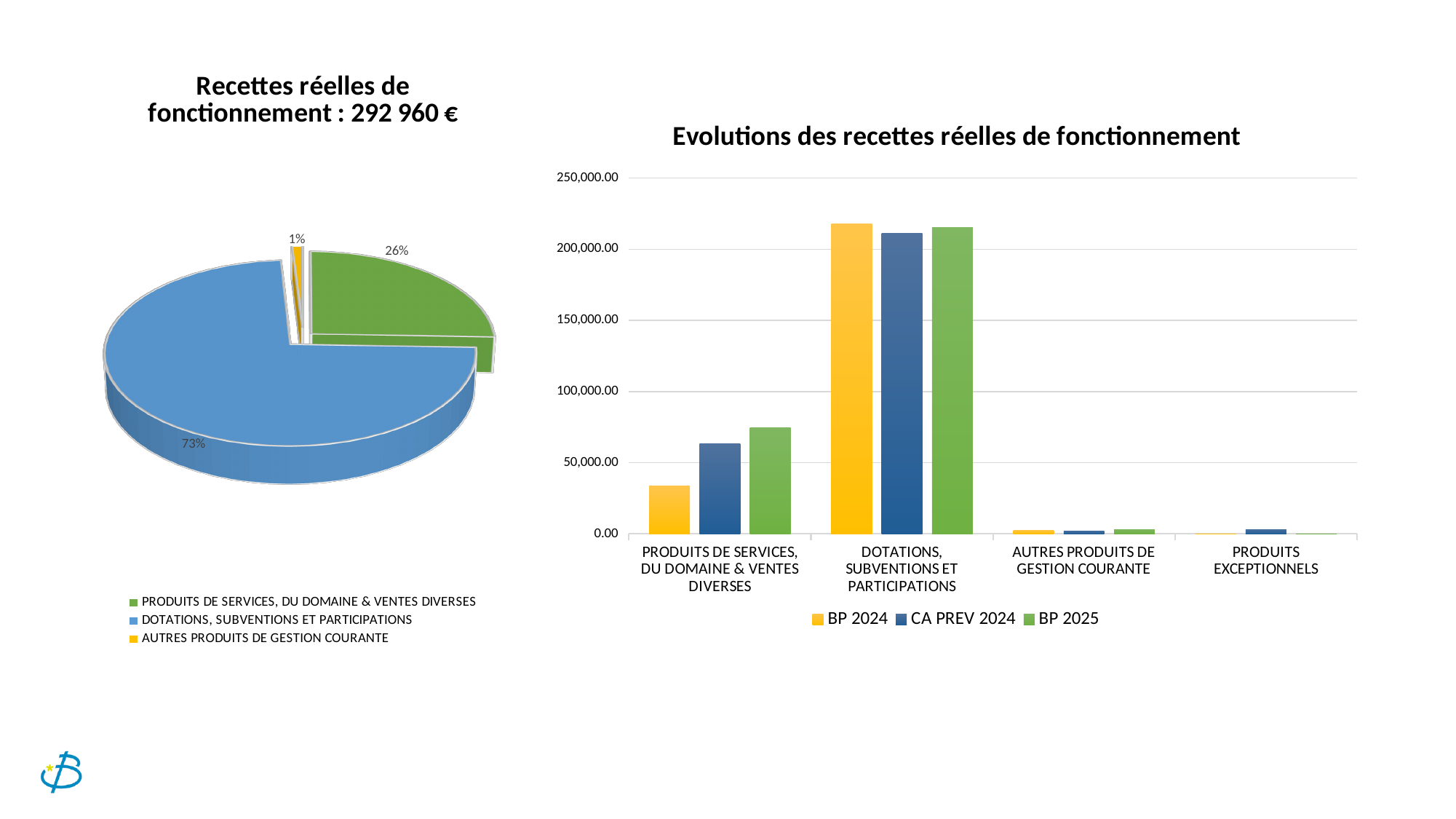
In the bar chart 'Evolutions des recettes réelles de fonctionnement', which category has the highest bars? DOTATIONS, SUBVENTIONS ET PARTICIPATIONS In the pie chart on the left, what share does PRODUITS DE SERVICES, DU DOMAINE & VENTES DIVERSES represent? 26% What total amount is given in the title of the pie chart on the left? 292 960 € In the bar chart 'Evolutions des recettes réelles de fonctionnement', how many series does the legend list? 3 In the bar chart 'Evolutions des recettes réelles de fonctionnement', which is larger for PRODUITS DE SERVICES, DU DOMAINE & VENTES DIVERSES: BP 2024 or BP 2025? BP 2025 What kind of chart is 'Evolutions des recettes réelles de fonctionnement'? bar chart In the pie chart titled 'Recettes réelles de fonctionnement', what share does DOTATIONS, SUBVENTIONS ET PARTICIPATIONS represent? 73% In the pie chart on the left, how many categories does the legend list? 3 In the bar chart 'Evolutions des recettes réelles de fonctionnement', is the BP 2024 value for DOTATIONS, SUBVENTIONS ET PARTICIPATIONS greater or less than 200,000.00? greater In the pie chart on the left, what share does AUTRES PRODUITS DE GESTION COURANTE represent? 1% In the bar chart 'Evolutions des recettes réelles de fonctionnement', how many categories are shown on the x axis? 4 In the pie chart on the left, which category has the largest slice? DOTATIONS, SUBVENTIONS ET PARTICIPATIONS